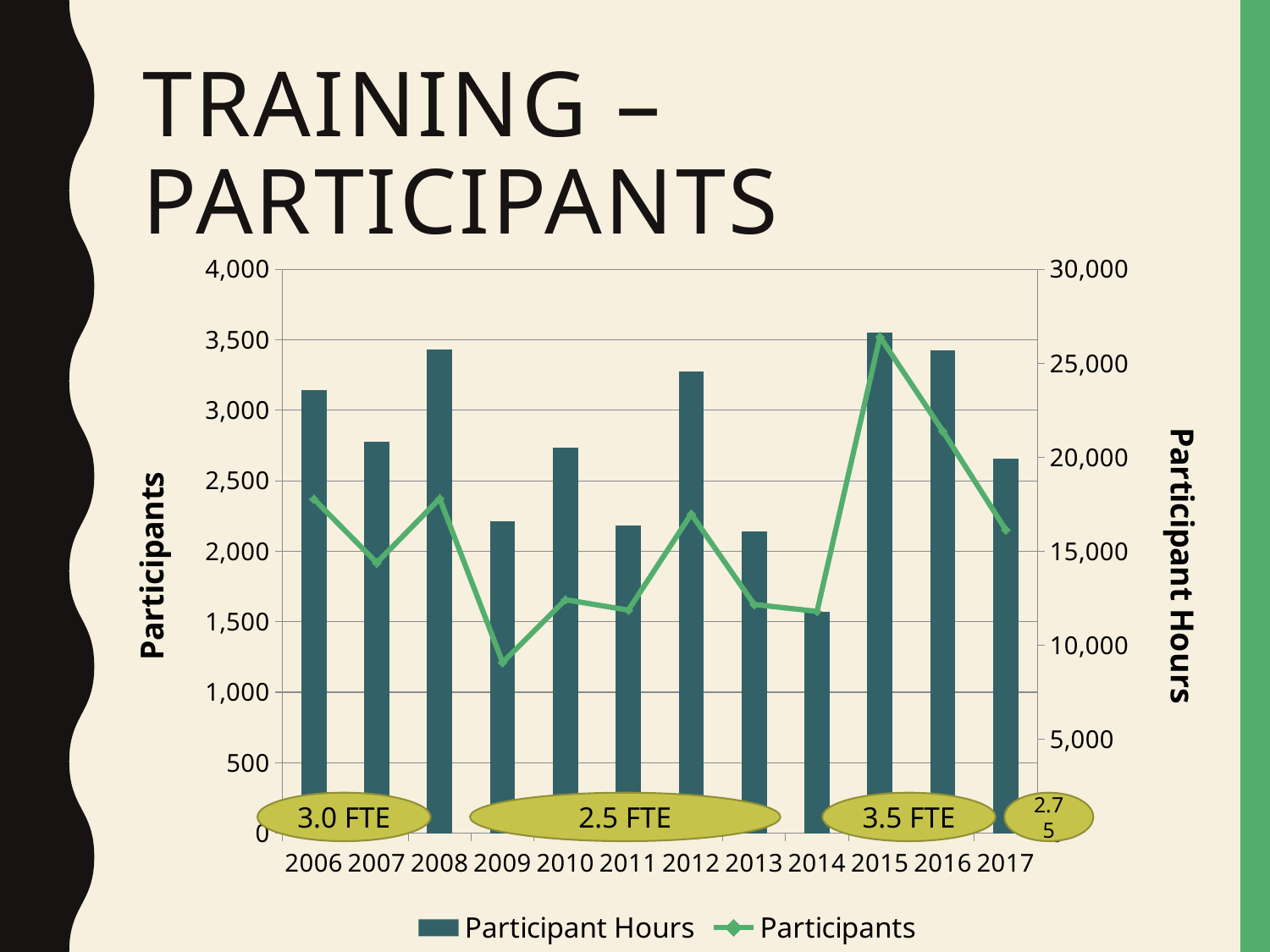
In which year is the Participants line at its lowest point? 2009 Is the Participants value for 2015 greater or less than 3,000? greater Which year has more Participant Hours, 2008 or 2009? 2008 What is the title of the right-hand vertical axis? Participant Hours How many series does the chart legend list? 2 What kind of chart is shown on the slide? Bar and line chart Which year has the lowest Participant Hours bar? 2014 Which year has the highest Participant Hours bar? 2015 How many years are shown on the x axis of the chart? 12 Is the Participant Hours value for 2006 greater or less than 20,000? greater Is the Participant Hours value for 2009 greater or less than 20,000? less Does the Participants line rise or fall from 2015 to 2017? fall